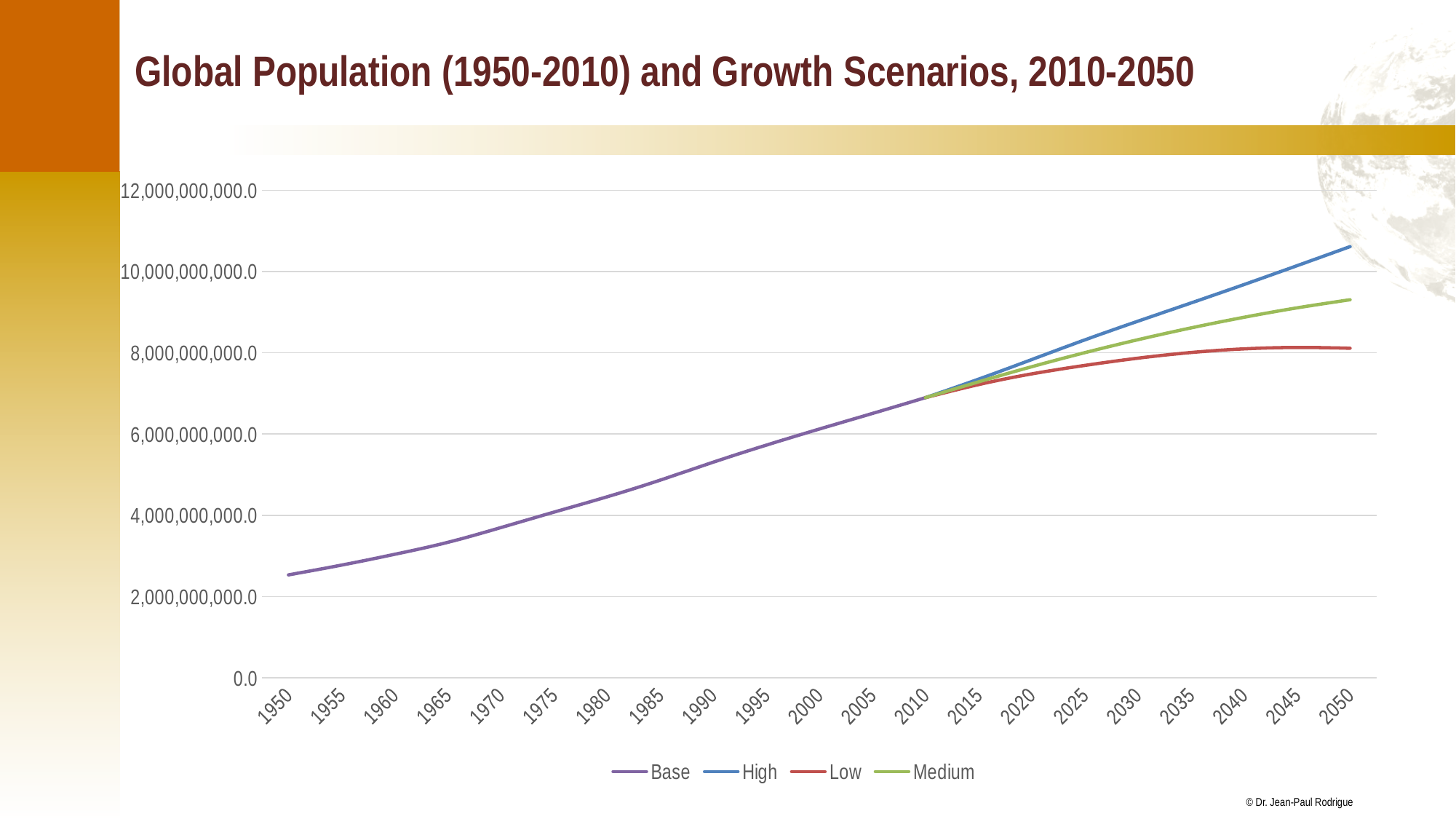
Does the Base series rise or fall from 1950 to 2010? Rises Is the value of the Low series in 2050 greater or less than 10,000,000,000.0? less Is the value of the High series in 2050 greater or less than 10,000,000,000.0? greater What is the title of the chart? Global Population (1950-2010) and Growth Scenarios, 2010-2050 How many series does the legend list? 4 How many year labels are shown on the x axis? 21 Is the value of the Base series in 1950 greater or less than 2,000,000,000.0? greater What kind of chart is shown on the slide? Line chart In 2050, which is larger: the High series or the Medium series? High Which series reaches the highest value in 2050? High Which series has the lowest value in 2050? Low